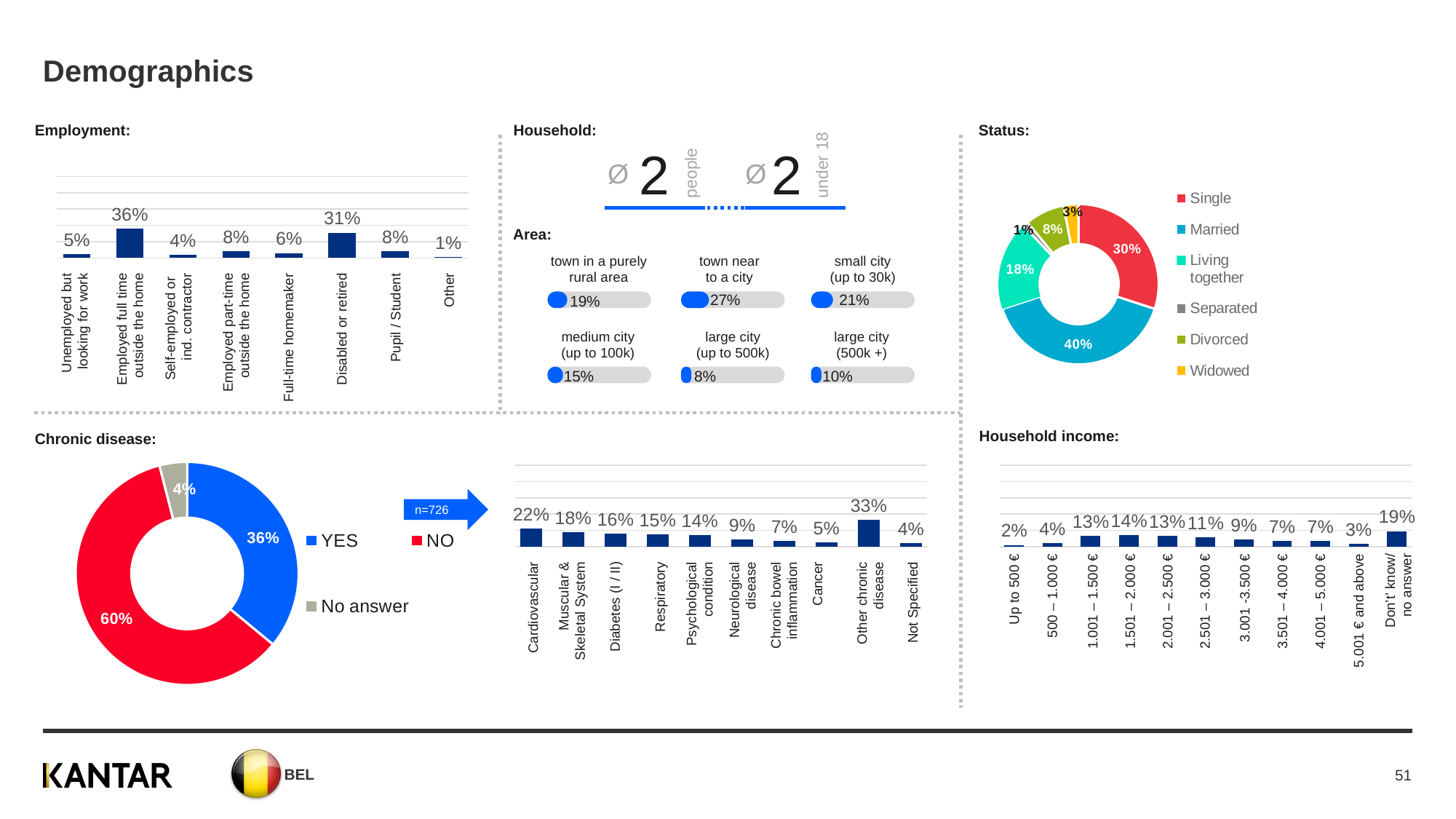
What kind of chart is used for the Chronic disease YES/NO breakdown? Donut (pie) chart In the chronic disease type bar chart, what percentage is shown for Cardiovascular? 22% In the chronic disease type bar chart (next to the n=726 arrow), which category has the highest value? Other chronic disease How many categories are shown in the Employment bar chart? 8 In the Status donut chart, which is larger: Living together or Divorced? Living together In the Employment bar chart, which category has the lowest value? Other How many entries does the legend of the Status donut chart list? 6 In the Employment bar chart, what is the difference between 'Employed full time outside the home' and 'Disabled or retired'? 5% In the Employment bar chart, what percentage is shown for 'Employed full time outside the home'? 36% In the Chronic disease donut chart, what share answered NO? 60% In the Household income bar chart, what percentage is shown for 'Don't know/ no answer'? 19% In the Status donut chart, what share is Married? 40%